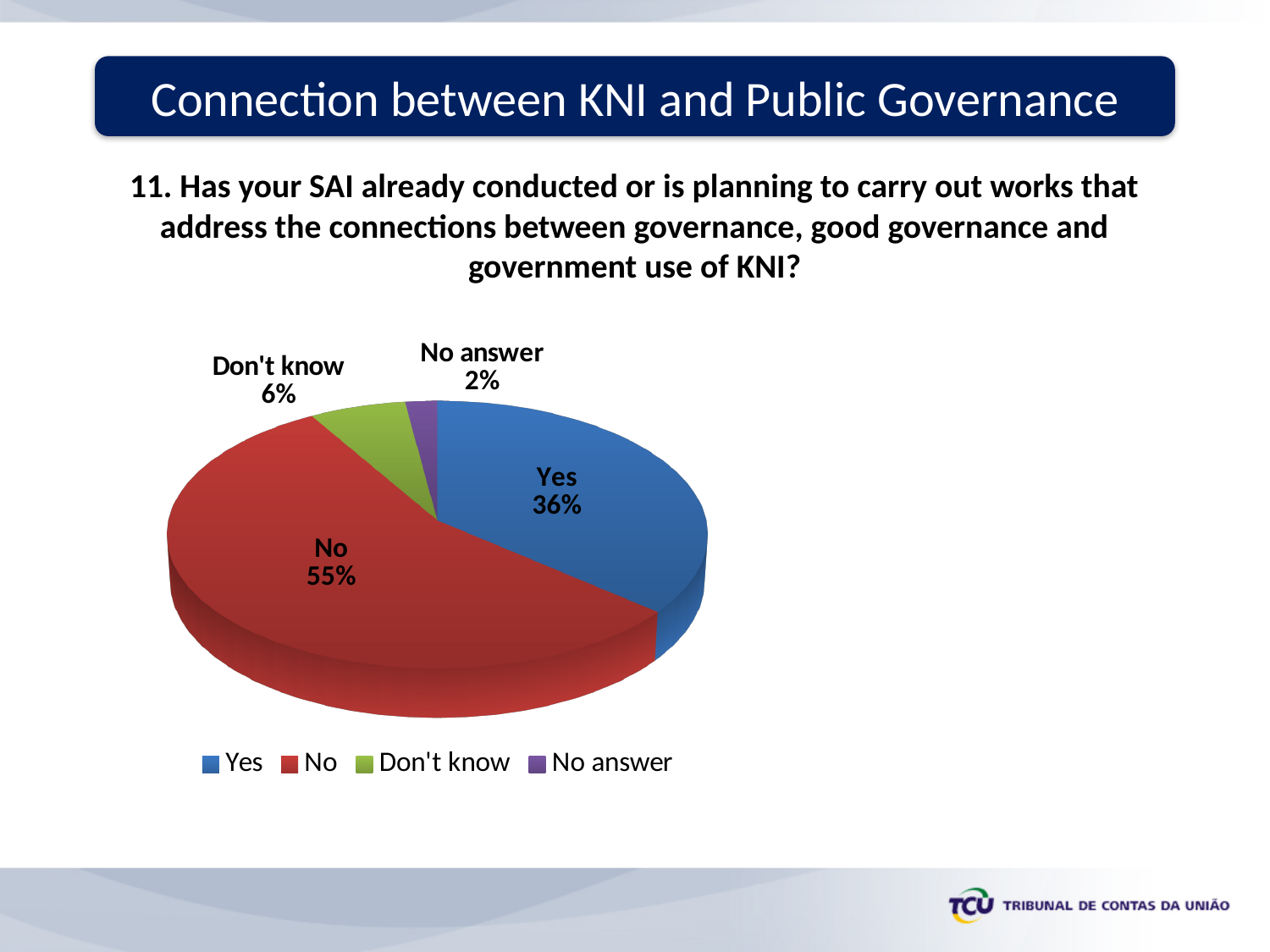
What kind of chart is shown on the slide? Pie chart What percentage of respondents answered "Don't know"? 6% What percentage of respondents answered "No"? 55% What is the difference in percentage points between the "No" and "Yes" shares? 19 What percentage of respondents gave "No answer"? 2% Which response has the smallest share of the pie? No answer Which response has the largest share of the pie? No How many slices does the pie chart have? 4 Which is larger, the share for "Yes" or the share for "Don't know"? Yes What percentage of respondents answered "Yes"? 36% How many entries does the legend list? 4 What colour is the "No" slice in the pie chart? Red